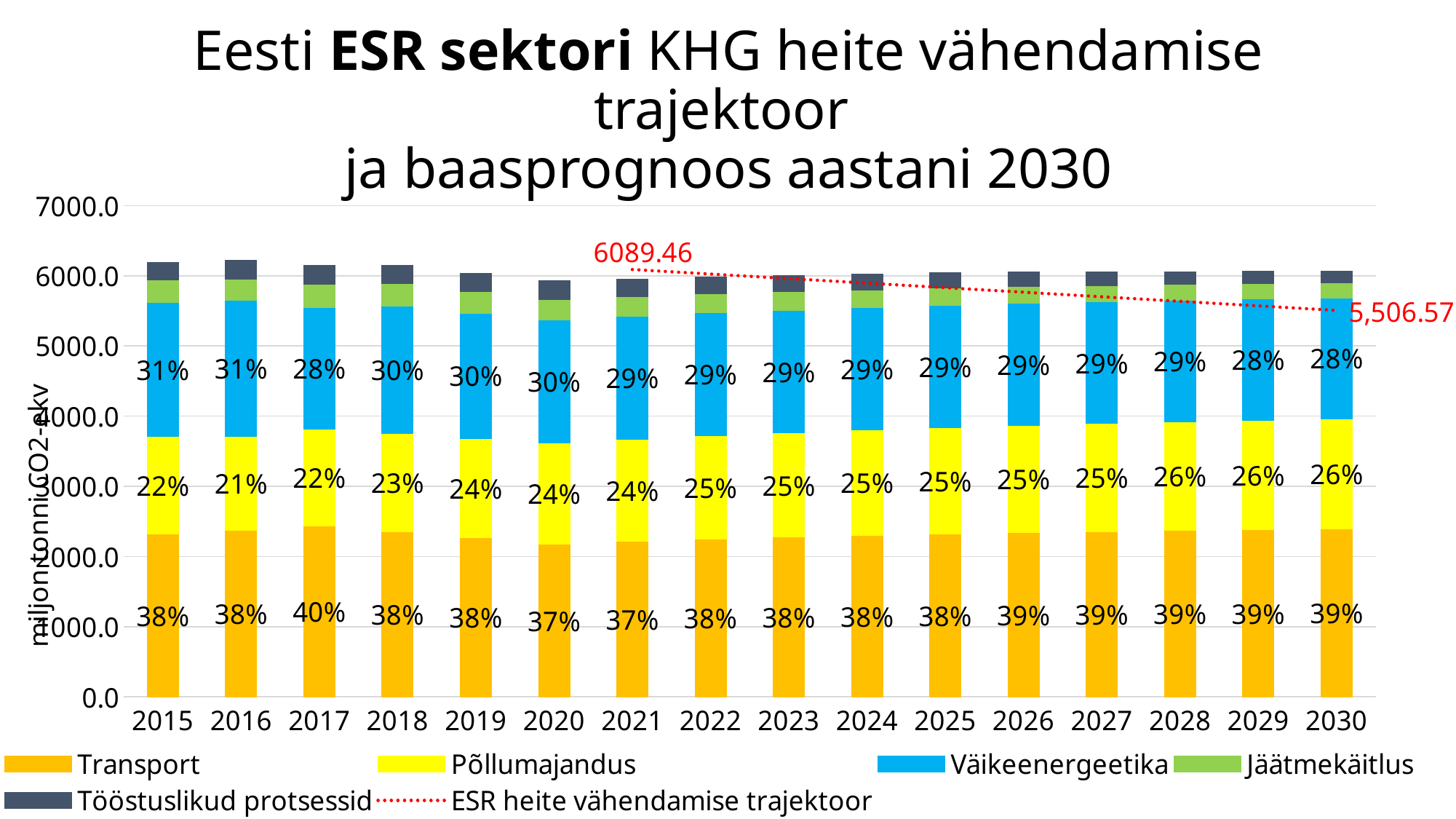
Does the ESR heite vähendamise trajektoor line rise or fall from 2021 to 2030? fall How many years are shown on the x axis? 16 How many entries does the legend list? 6 What percentage share does Transport have in 2017? 40% Is the total stacked bar value for 2015 greater or less than 6000? greater By how many percentage points does the Väikeenergeetika share in 2015 exceed its share in 2030? 3 percentage points In which year is the Transport percentage share highest? 2017 What value is labelled at the start of the ESR heite vähendamise trajektoor line? 6089.46 What value is labelled at the end of the ESR heite vähendamise trajektoor line in 2030? 5,506.57 What percentage share does Põllumajandus have in 2030? 26% Which year has the larger Transport percentage share, 2015 or 2017? 2017 What percentage share does Väikeenergeetika have in 2015? 31%